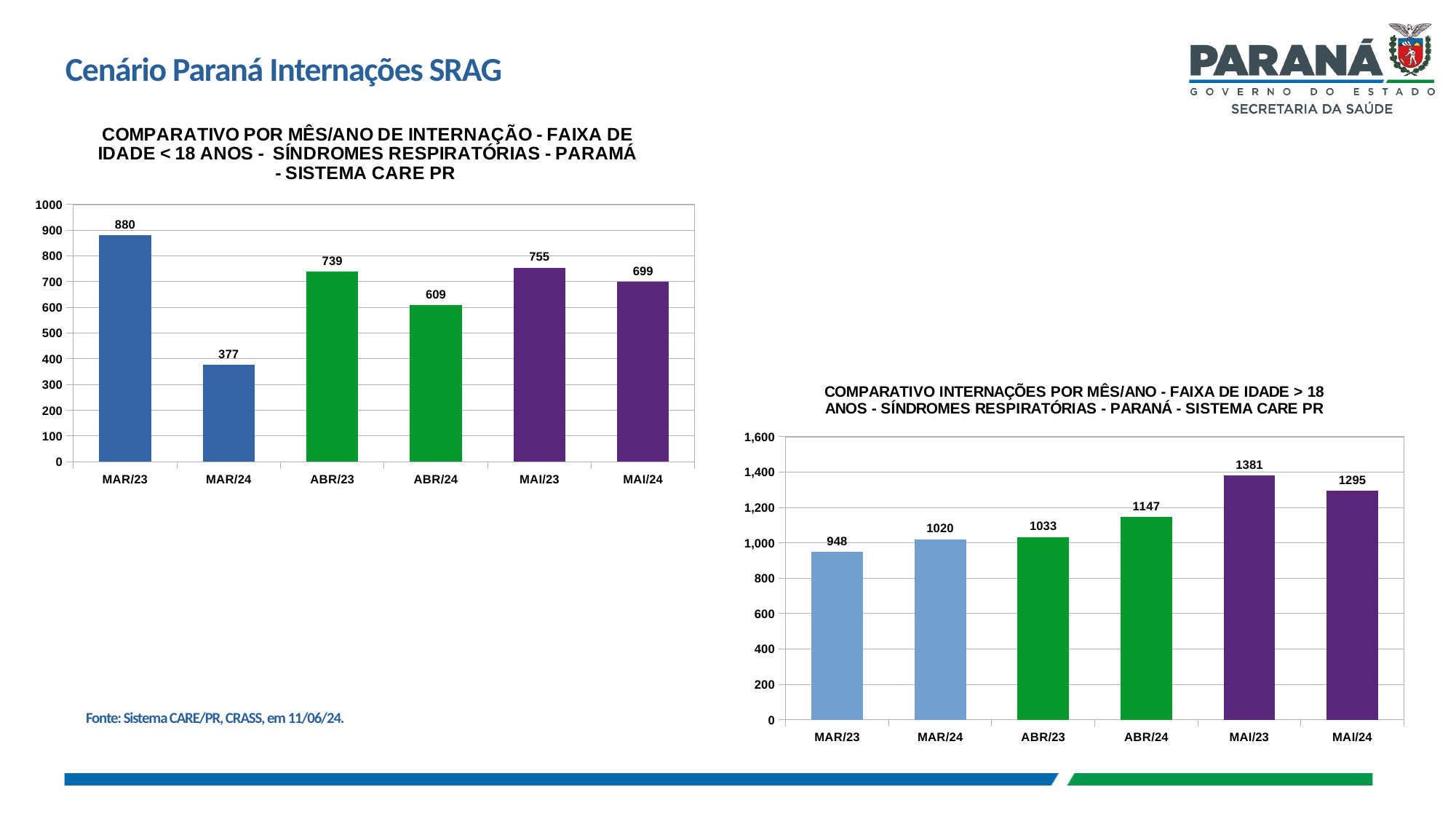
In the left chart (faixa de idade < 18 anos), which month/year has the lowest value? MAR/24 In the right chart (faixa de idade > 18 anos), which month/year has the lowest value? MAR/23 In the left chart (faixa de idade < 18 anos), what is the value for MAR/23? 880 In the right chart (faixa de idade > 18 anos), what is the difference between MAI/23 and MAI/24? 86 In the left chart (faixa de idade < 18 anos), how many bars are plotted? 6 In the left chart (faixa de idade < 18 anos), what is the difference between MAR/23 and MAR/24? 503 In the right chart (faixa de idade > 18 anos), which is larger, ABR/23 or ABR/24? ABR/24 In the right chart (faixa de idade > 18 anos), what is the value for MAI/23? 1381 In the left chart (faixa de idade < 18 anos), which month/year has the highest value? MAR/23 What type of chart is the right chart (faixa de idade > 18 anos)? Bar chart In the left chart (faixa de idade < 18 anos), what is the value for ABR/24? 609 In the right chart (faixa de idade > 18 anos), what is the value for MAR/24? 1020